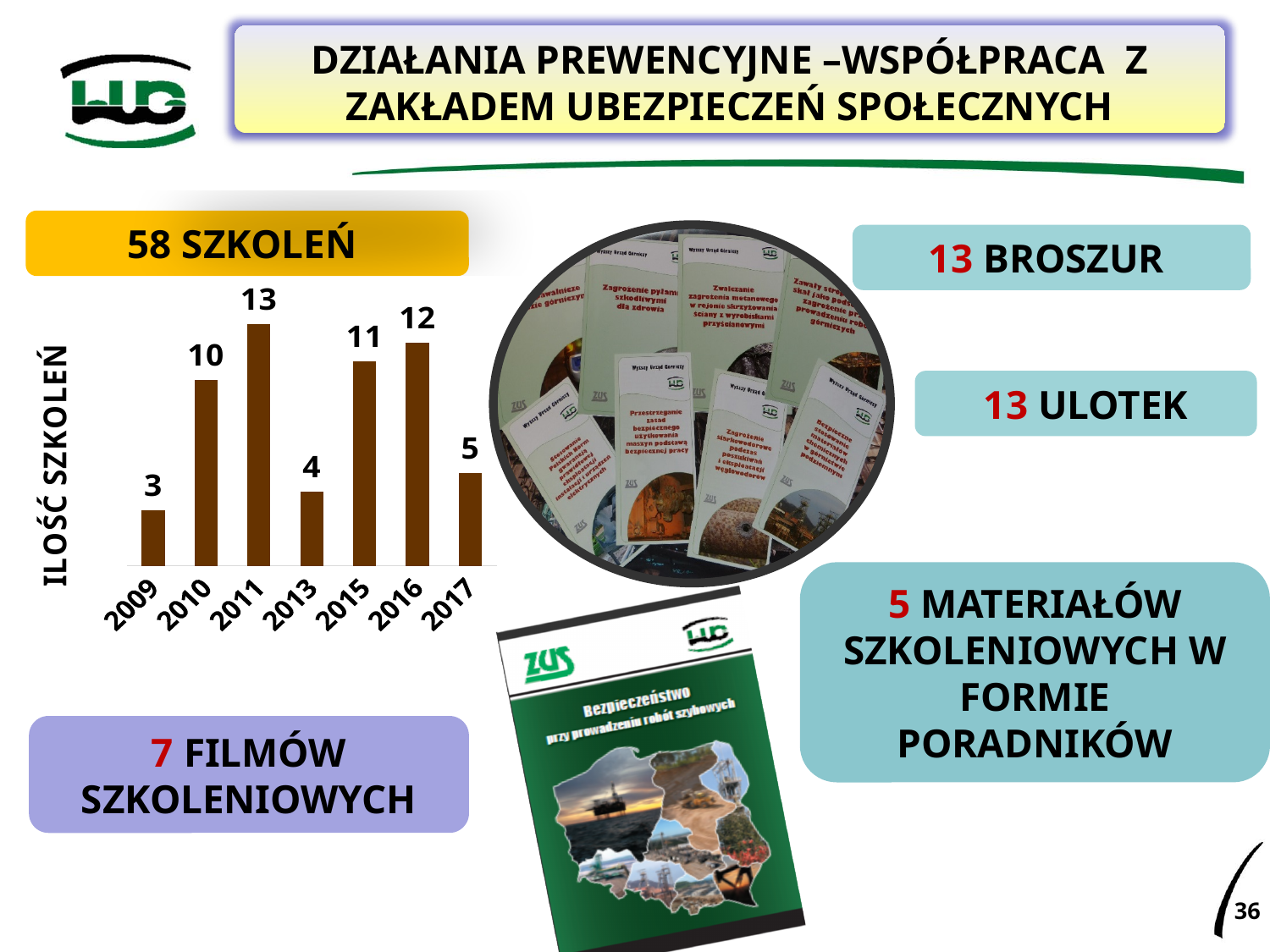
What is the value for 2016 in the bar chart? 12 What is the value for 2013 in the bar chart? 4 Which year has the highest value in the bar chart? 2011 What kind of chart is shown on the slide? bar chart What is the value for 2011 in the bar chart? 13 What is the difference between the values for 2011 and 2009 in the bar chart? 10 What is the label on the y axis of the bar chart? ILOŚĆ SZKOLEŃ What is the difference between the values for 2016 and 2017 in the bar chart? 7 Which year has the lowest value in the bar chart? 2009 How many years are shown on the x axis of the bar chart? 7 Which is larger in the bar chart, the value for 2010 or the value for 2015? 2015